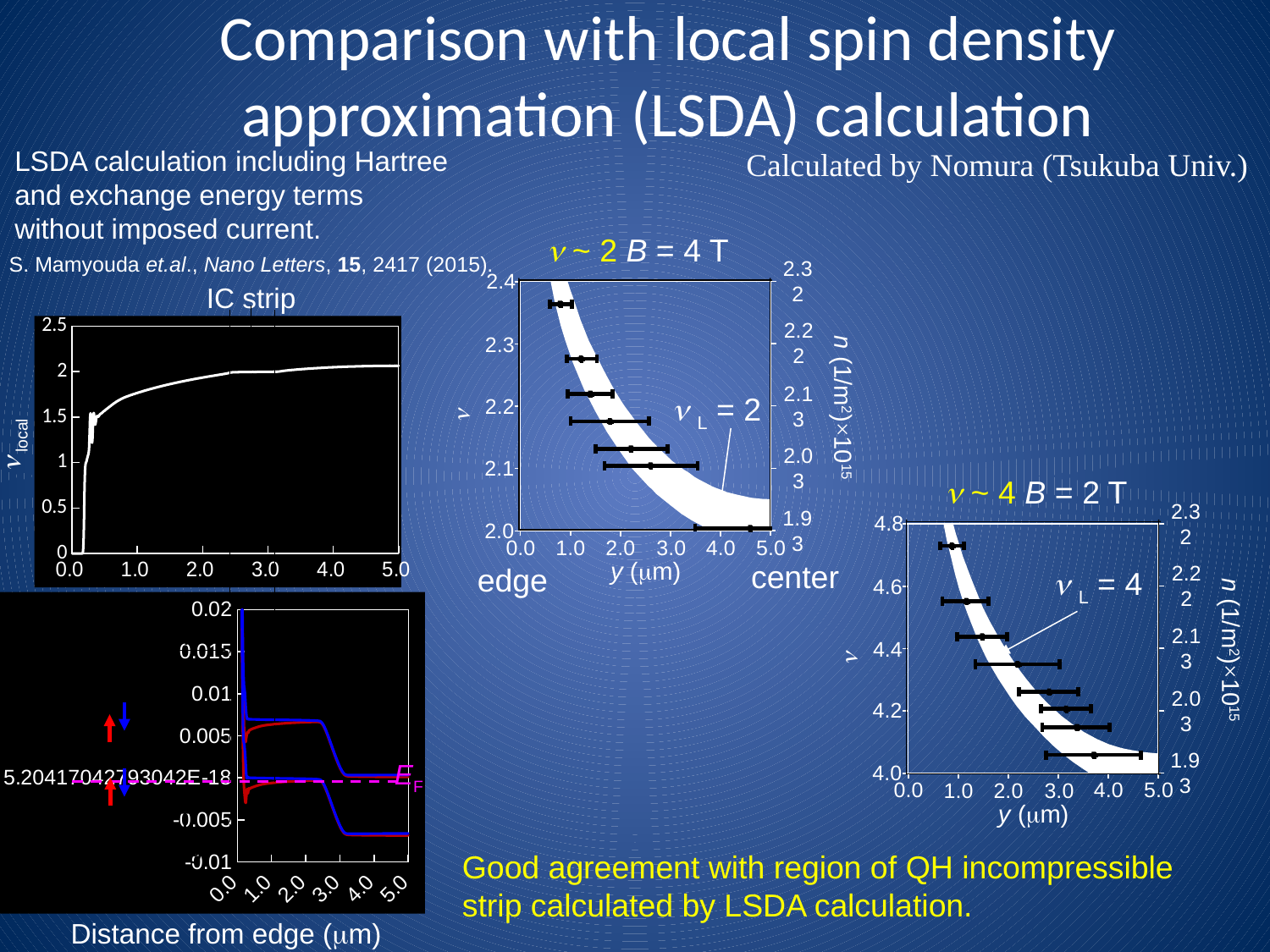
In the 'ν ~ 4 B = 2 T' chart, is the ν value of the lowest data point greater or less than 4.2? less In the 'ν ~ 4 B = 2 T' chart, is the ν value of the topmost data point greater or less than 4.6? greater In the 'ν ~ 2 B = 4 T' chart, is the ν value of the data point nearest the edge (around y = 0.8 μm) greater or less than 2.3? greater What is the x-axis label of the 'ν ~ 4 B = 2 T' chart? y (μm) How many data points (horizontal error bars) are plotted in the 'ν ~ 4 B = 2 T' chart? 7 What is the highest tick value on the left ν axis of the 'ν ~ 2 B = 4 T' chart? 2.4 What is the lowest tick value on the left ν axis of the 'ν ~ 4 B = 2 T' chart? 4.0 What kind of chart is the 'IC strip' chart on the left of the slide? line chart In the 'IC strip' chart, does ν_local rise or fall as the distance from the edge increases from 0.0 to 5.0? rises What magnetic field is stated in the title of the chart in the middle of the slide? B = 4 T